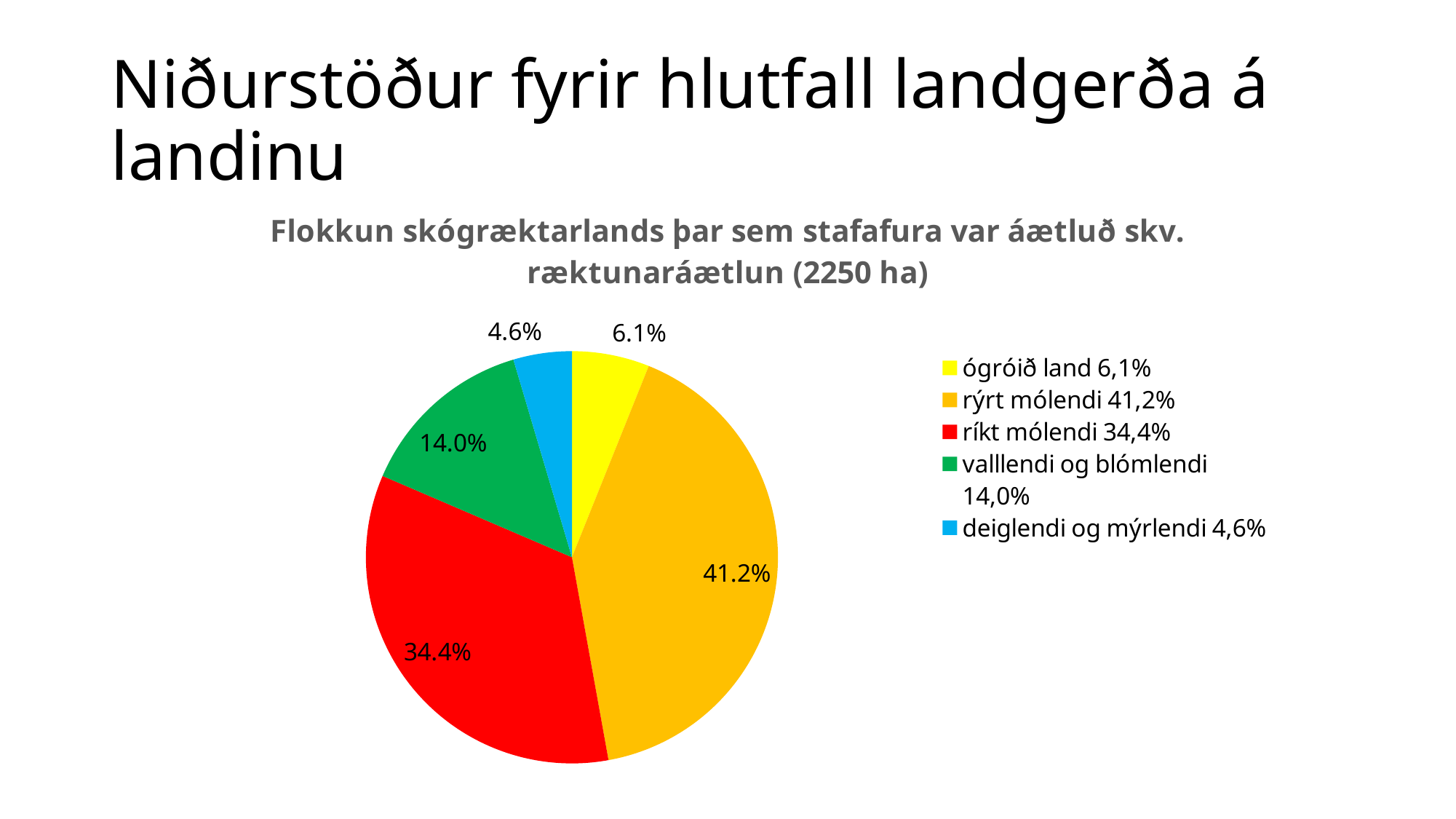
Which category has the smallest slice of the pie? deiglendi og mýrlendi How many slices does the pie chart have? 5 What share of the pie does deiglendi og mýrlendi have? 4.6% What share of the pie does rýrt mólendi have? 41.2% What share of the pie does ógróið land have? 6.1% Which category has the largest slice of the pie? rýrt mólendi What kind of chart is shown on the slide? pie chart Which is larger, the slice for ógróið land or the slice for deiglendi og mýrlendi? ógróið land What share of the pie does ríkt mólendi have? 34.4% What share of the pie does valllendi og blómlendi have? 14.0% What is the difference in percentage points between rýrt mólendi and ríkt mólendi? 6.8 What colour is the slice for valllendi og blómlendi? green